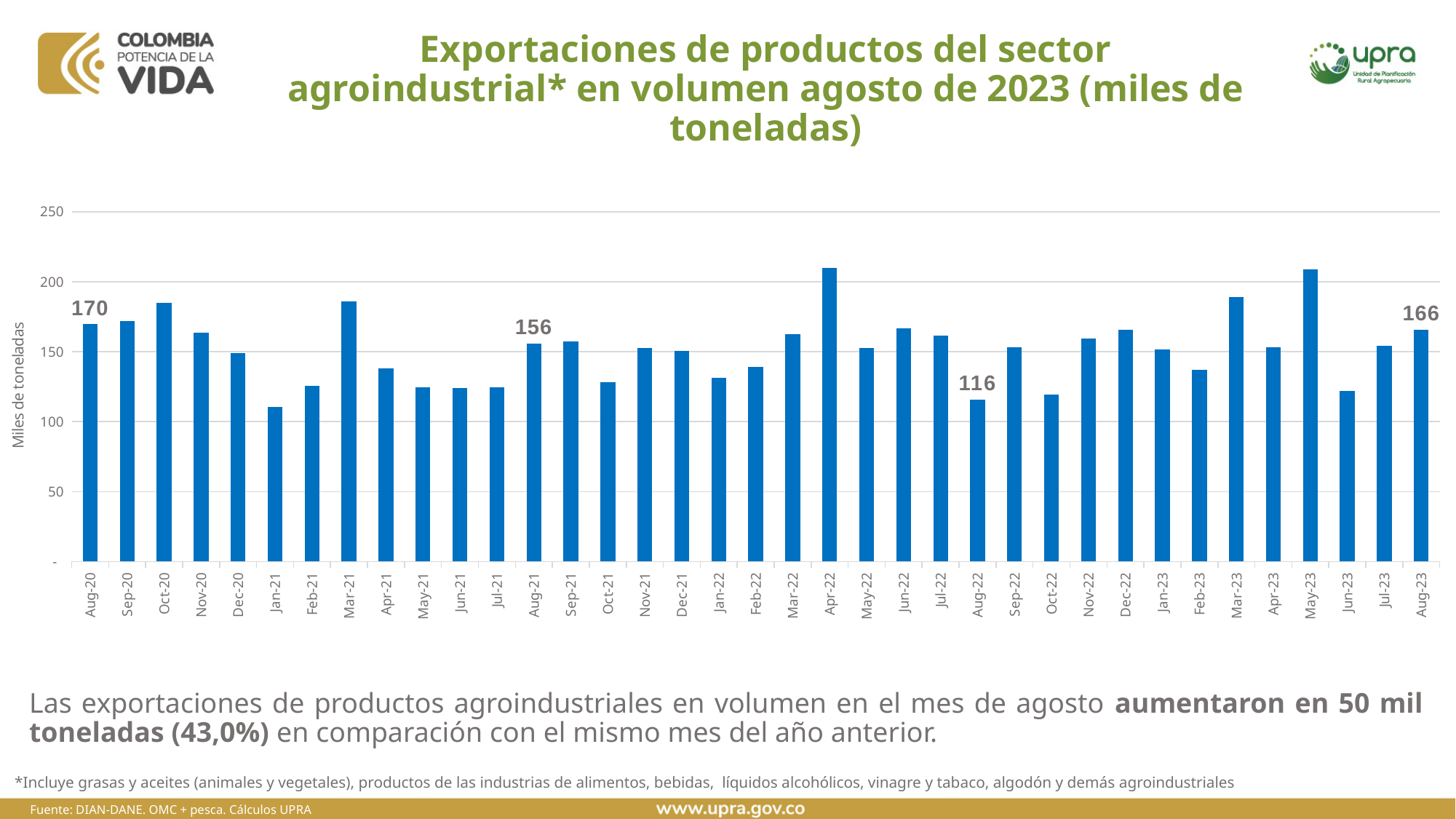
What is the value for Aug-21? 156 Is the value for Apr-22 greater or less than 200? greater What kind of chart is shown on the slide? bar chart What is the difference between the values for Aug-23 and Aug-22? 50 How many months (bars) are shown on the chart? 37 Is the value for Jan-21 greater or less than 150? less What is the value for Aug-20? 170 What is the label of the vertical axis? Miles de toneladas Which is larger, the value for Aug-20 or the value for Aug-22? Aug-20 What is the difference between the values for Aug-20 and Aug-21? 14 What is the value for Aug-22? 116 What is the value for Aug-23? 166